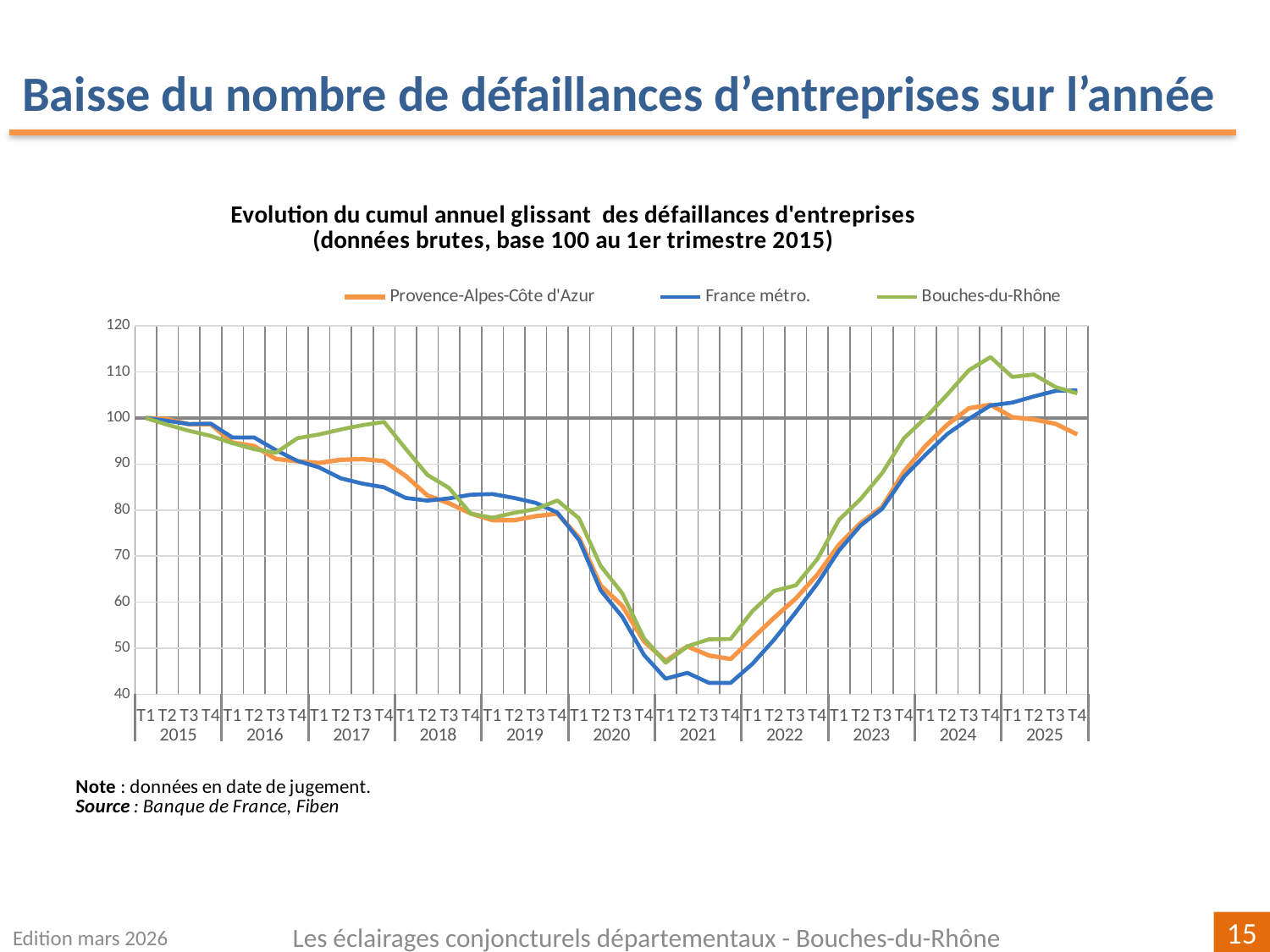
Which series are listed in the legend? Provence-Alpes-Côte d'Azur, France métro., Bouches-du-Rhône Is the value for Bouches-du-Rhône at T4 2024 greater or less than 110? greater Do the values of the France métro. series rise or fall between T1 2015 and T4 2021? fall Which series has the highest value at T4 2024? Bouches-du-Rhône How many series does the legend list? 3 Which series has the lowest value at T4 2021? France métro. What is the value of the France métro. series at T1 2015? 100 At T4 2025, which is larger: the value for France métro. or the value for Provence-Alpes-Côte d'Azur? France métro. Is the value for France métro. at T4 2021 greater or less than 50? less How many years are shown along the x axis? 11 Is the value for Provence-Alpes-Côte d'Azur at T4 2025 greater or less than 100? less What kind of chart is shown on the slide? line chart